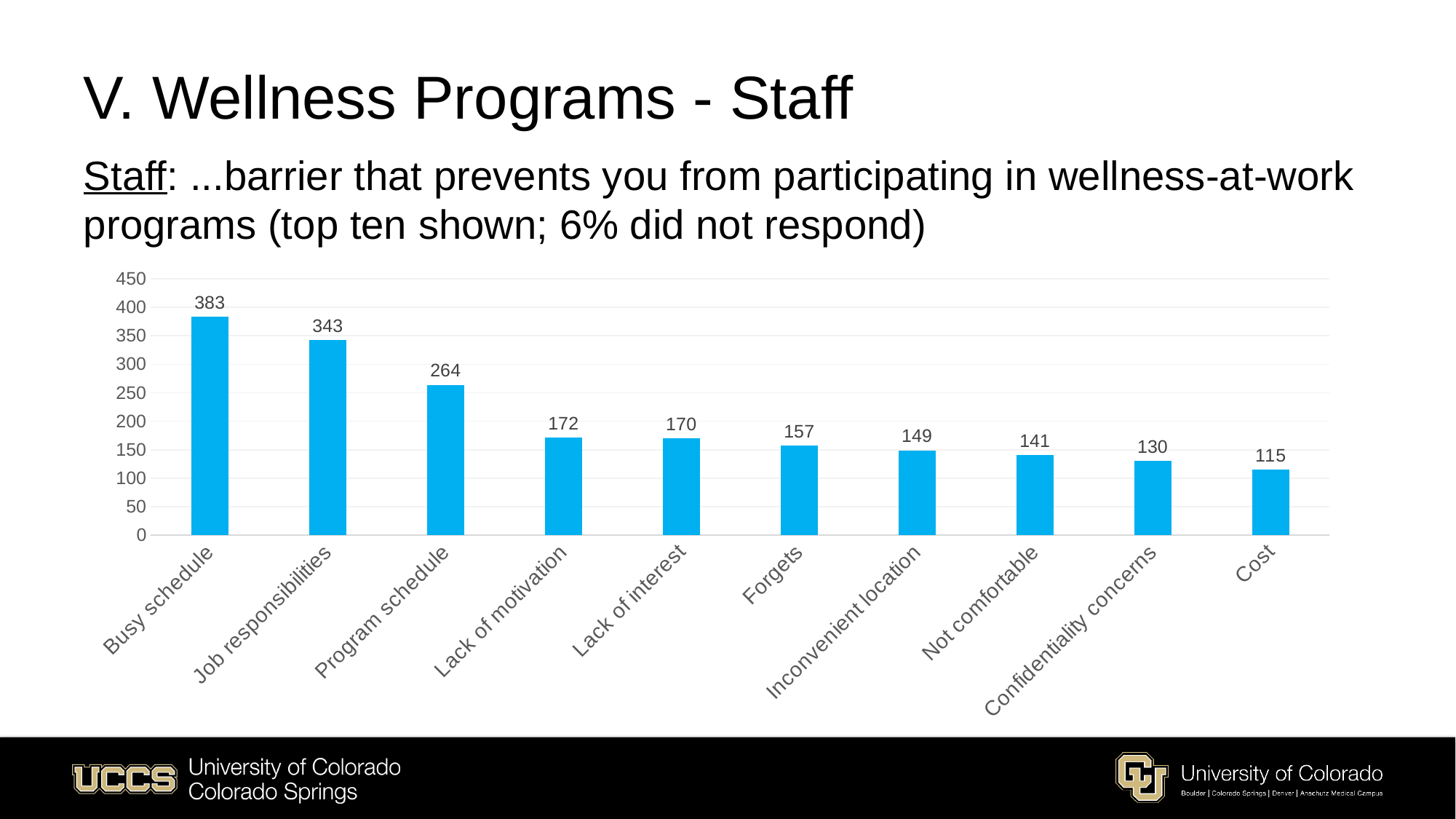
Do the values rise or fall from left to right across the categories? Fall Is the value for Program schedule greater or less than 250? greater What is the difference between Program schedule and Cost? 149 What is the value for Busy schedule? 383 What kind of chart is shown on the slide? Bar chart What is the value for Inconvenient location? 149 What is the value for Confidentiality concerns? 130 How many barriers are shown in the chart? 10 Which is larger, Forgets or Not comfortable? Forgets Which barrier has the highest value? Busy schedule What is the difference between Busy schedule and Job responsibilities? 40 Which barrier has the lowest value? Cost